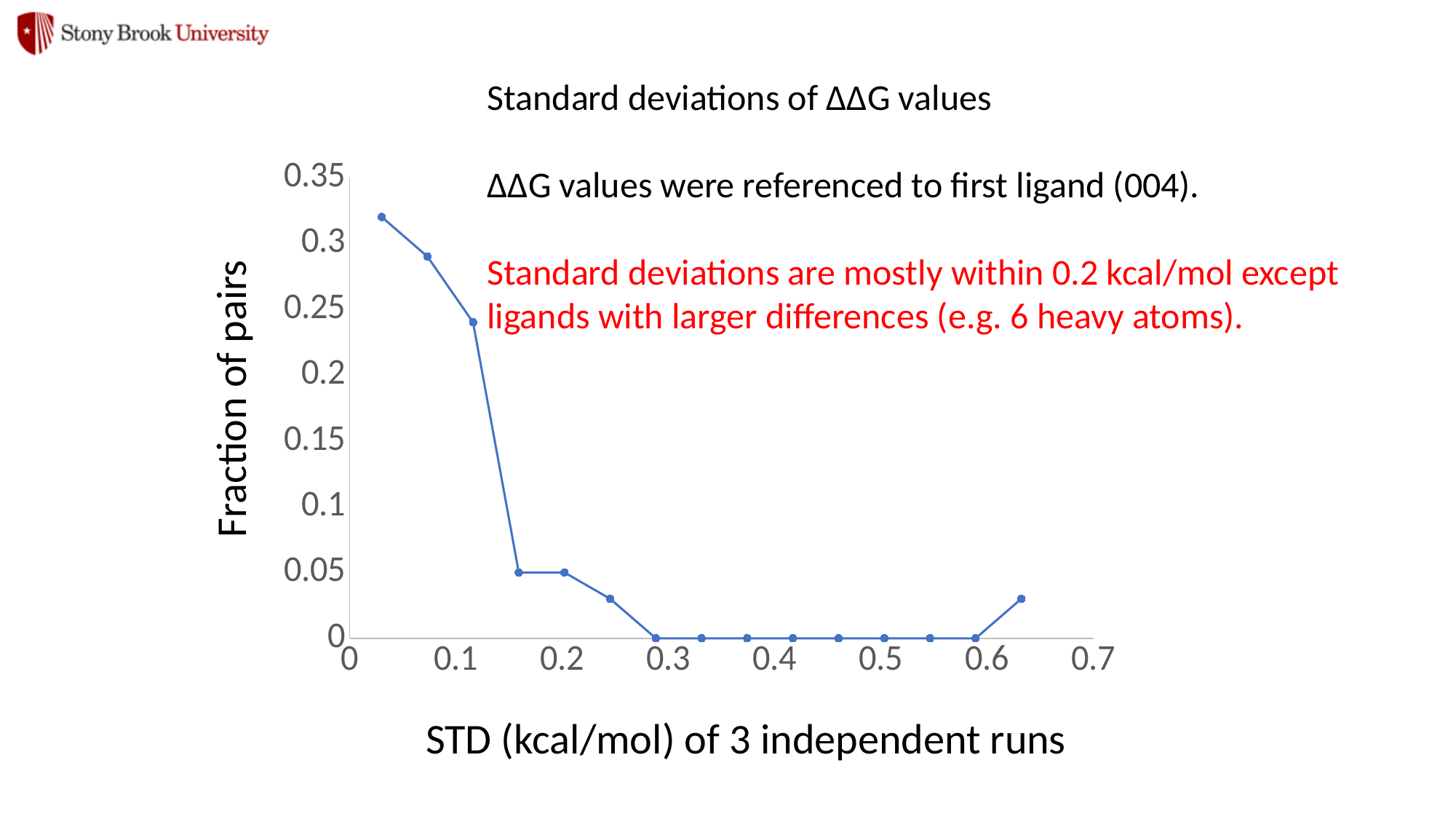
What is the fraction of pairs for the point closest to STD 0.5 on the x axis? 0 Is the fraction of pairs for the rightmost point greater or less than 0.05? less What kind of chart is shown on the slide? line chart Which point on the line has the highest fraction of pairs? the leftmost point (smallest STD) How many data points are plotted on the line? 15 Is the fraction of pairs for the fourth point from the left greater or less than 0.1? less Does the fraction of pairs generally rise or fall as STD increases from 0 to 0.3? fall What is the title of the x axis of the chart? STD (kcal/mol) of 3 independent runs Is the fraction of pairs for the leftmost point (smallest STD) greater or less than 0.3? greater What is the title of the y axis of the chart? Fraction of pairs Which point has the highest fraction of pairs: the leftmost point or the rightmost point? the leftmost point